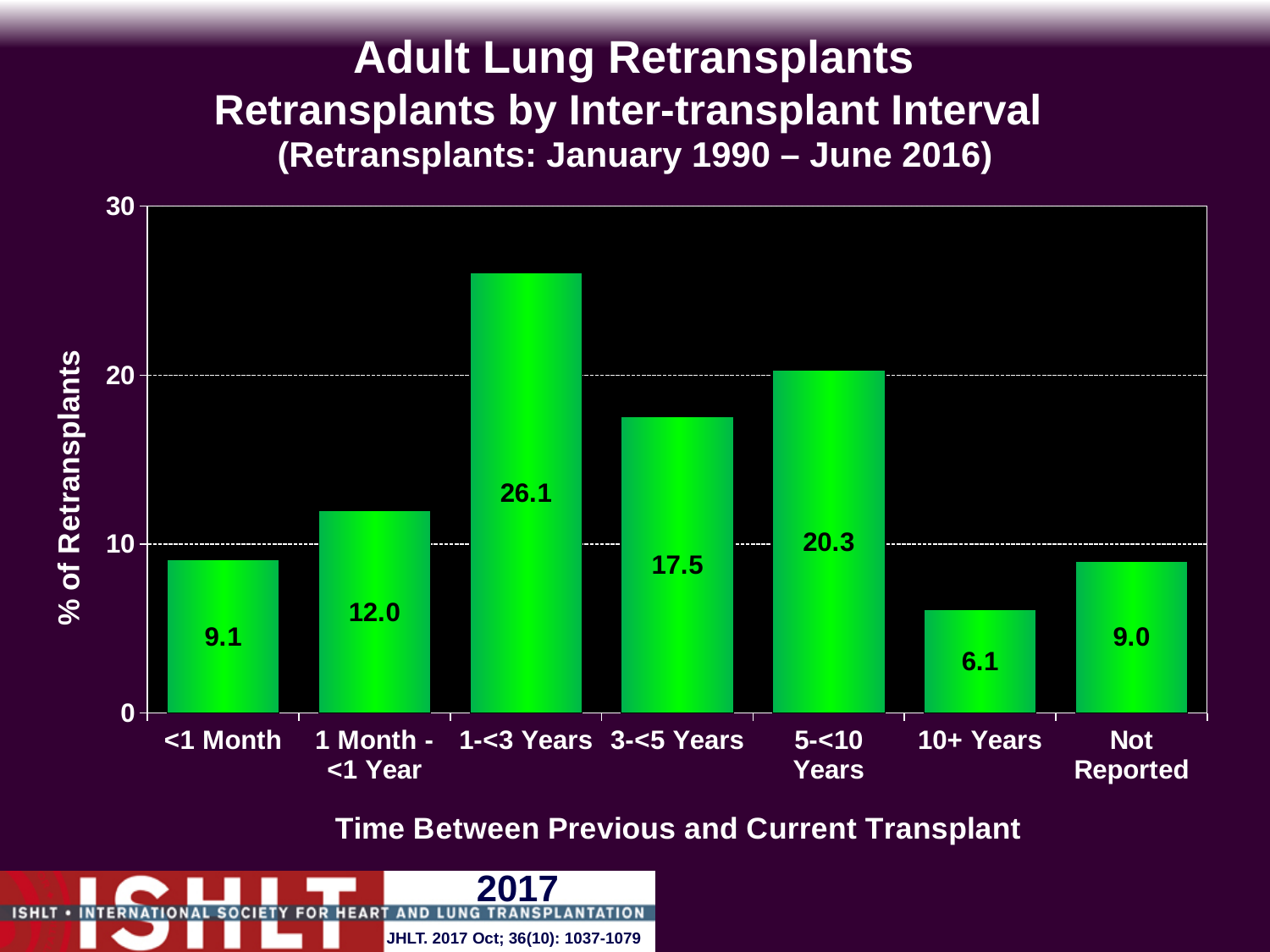
What is the difference between the values for 1-<3 Years and 5-<10 Years? 5.8 What is the label of the x axis? Time Between Previous and Current Transplant Which is larger, the value for 3-<5 Years or the value for 1 Month - <1 Year? 3-<5 Years What kind of chart is shown on the slide? Bar chart Which inter-transplant interval category has the highest percentage of retransplants? 1-<3 Years What percentage of retransplants had an inter-transplant interval of 1-<3 Years? 26.1 Which category has the lowest percentage of retransplants? 10+ Years What is the value for the 10+ Years category? 6.1 Is the value for 5-<10 Years greater or less than 20? greater What is the label of the y axis? % of Retransplants How many inter-transplant interval categories are shown on the x axis? 7 What percentage of retransplants is shown for the Not Reported category? 9.0